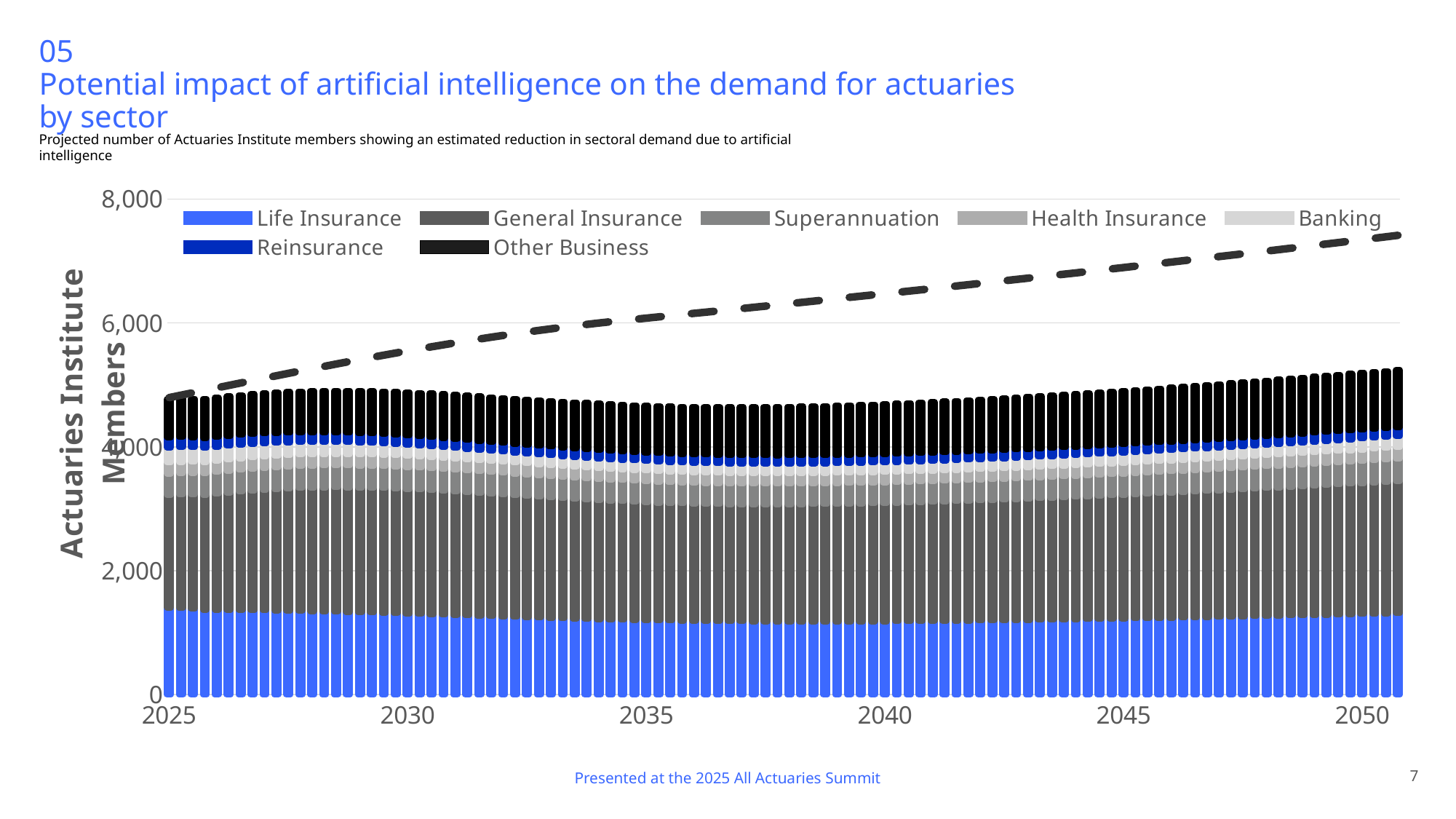
Which series is listed first in the legend? Life Insurance Is the total height of the stacked bar for 2025 greater or less than 6,000? less Is the Life Insurance value for 2025 greater or less than 2,000? less What is the title of the vertical axis? Actuaries Institute Members At 2050, which is higher: the dashed line or the top of the stacked bar? the dashed line What kind of chart is shown on the slide? Stacked bar chart with a dashed line Is the value of the dashed line at 2050 greater or less than 6,000? greater Does the dashed line rise or fall from 2025 to 2050? rises What is the first year shown on the x axis? 2025 Which series is shown in the bottom segment of each stacked bar? Life Insurance How many series does the legend list? 7